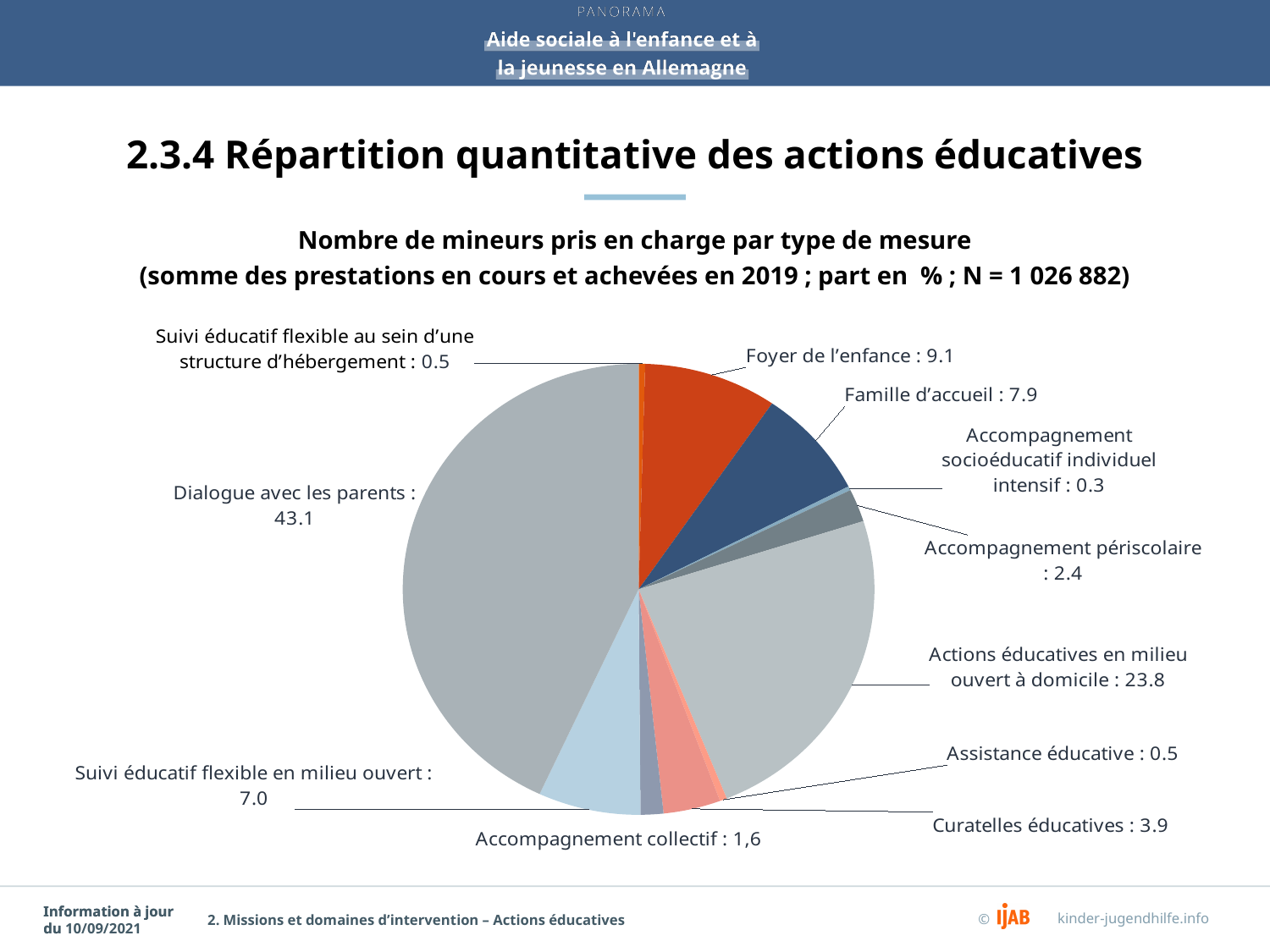
What is the value of N stated in the chart title? 1 026 882 What is the value shown for Accompagnement collectif? 1,6 What is the difference between the values for Dialogue avec les parents and Actions éducatives en milieu ouvert à domicile? 19.3 What is the value shown for Dialogue avec les parents? 43.1 How many categories are shown in the pie chart? 11 What kind of chart is shown on the slide? pie chart Which category has the smallest share of the pie? Accompagnement socioéducatif individuel intensif What is the value shown for Foyer de l'enfance? 9.1 What is the value shown for Curatelles éducatives? 3.9 Which is larger, the value for Foyer de l'enfance or the value for Famille d'accueil? Foyer de l'enfance Which category has the largest share of the pie? Dialogue avec les parents What is the value shown for Actions éducatives en milieu ouvert à domicile? 23.8